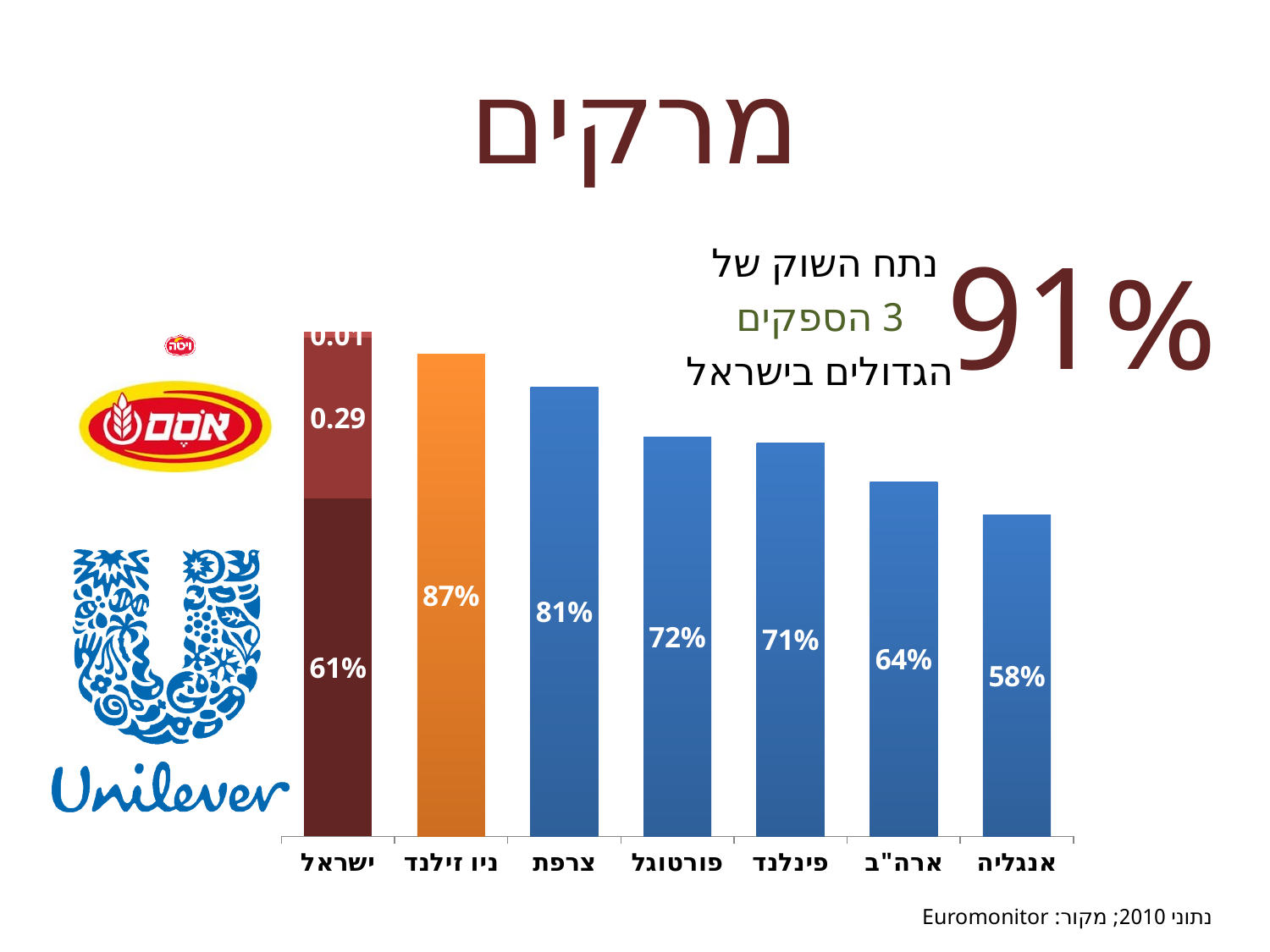
What is the value shown for ניו זילנד (New Zealand)? 87% Do the bar values rise or fall moving from left to right across the chart? fall Which country has the lowest value in the chart? אנגליה (England) Which has a larger value, פורטוגל (Portugal) or ארה"ב (USA)? פורטוגל (Portugal) What is the value shown for אנגליה (England)? 58% How many countries are shown on the x axis of the chart? 7 What is the value shown for צרפת (France)? 81% What is the difference between the values for ניו זילנד (New Zealand) and צרפת (France)? 6 percentage points Which country has the tallest bar in the chart? ישראל (Israel) What is the value of the bottom segment of the stacked bar for ישראל (Israel)? 61% What type of chart is shown on the slide? bar chart What source is cited for the chart data at the bottom of the slide? Euromonitor